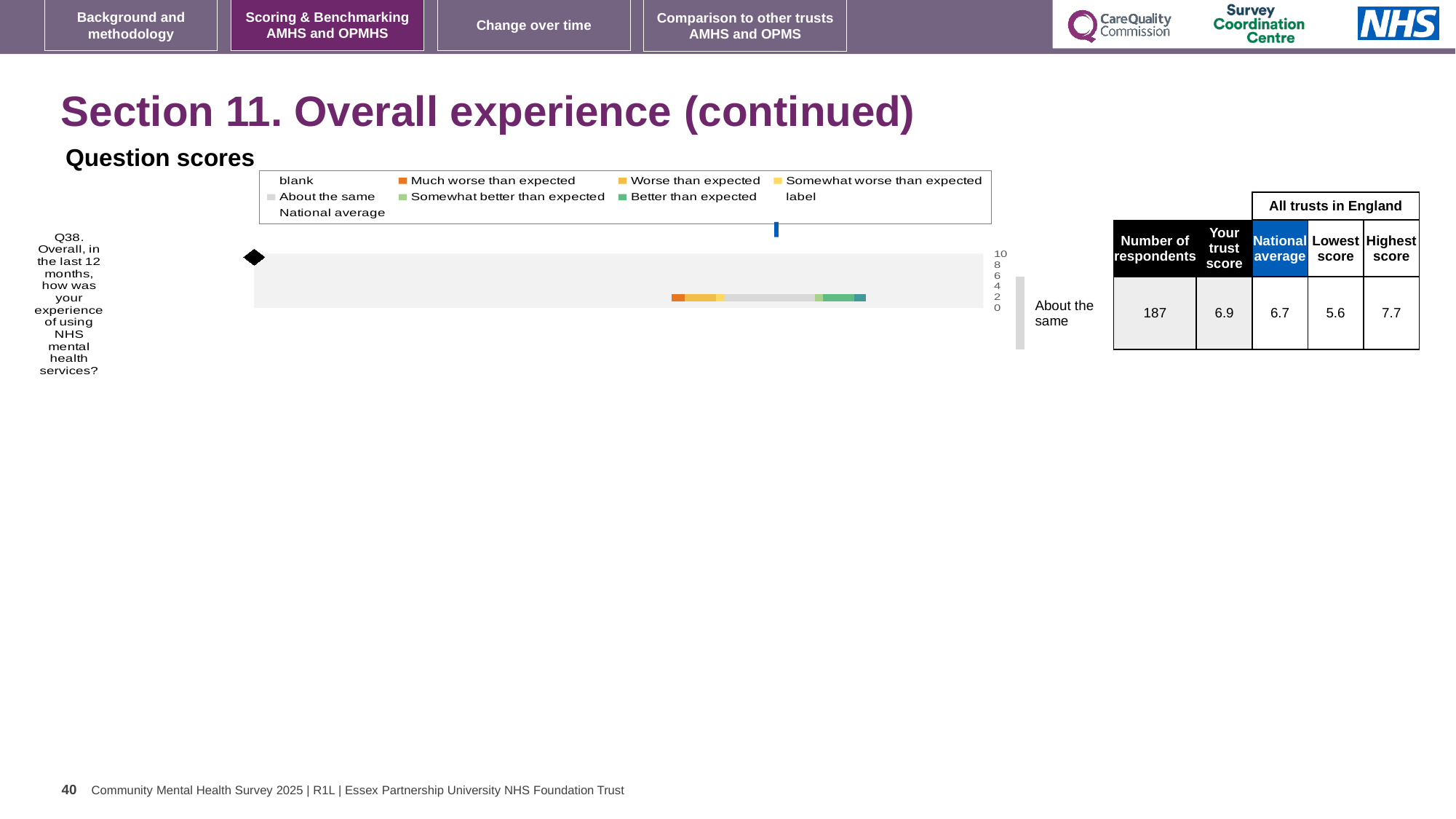
What is the difference between the highest score and the lowest score for Q38? 2.1 How many survey questions are plotted in the Question scores chart? 1 Which benchmark category is the trust's Q38 score placed in? About the same What is the national average score for Q38? 6.7 What colour represents 'Much worse than expected' in the chart legend? orange Which is larger for Q38, the trust score or the national average? the trust score What is the lowest score among all trusts in England for Q38? 5.6 What kind of chart is used to show the Q38 question score? bar chart What is the highest score among all trusts in England for Q38? 7.7 How many respondents answered Q38? 187 What is the trust score for Q38 shown alongside the chart? 6.9